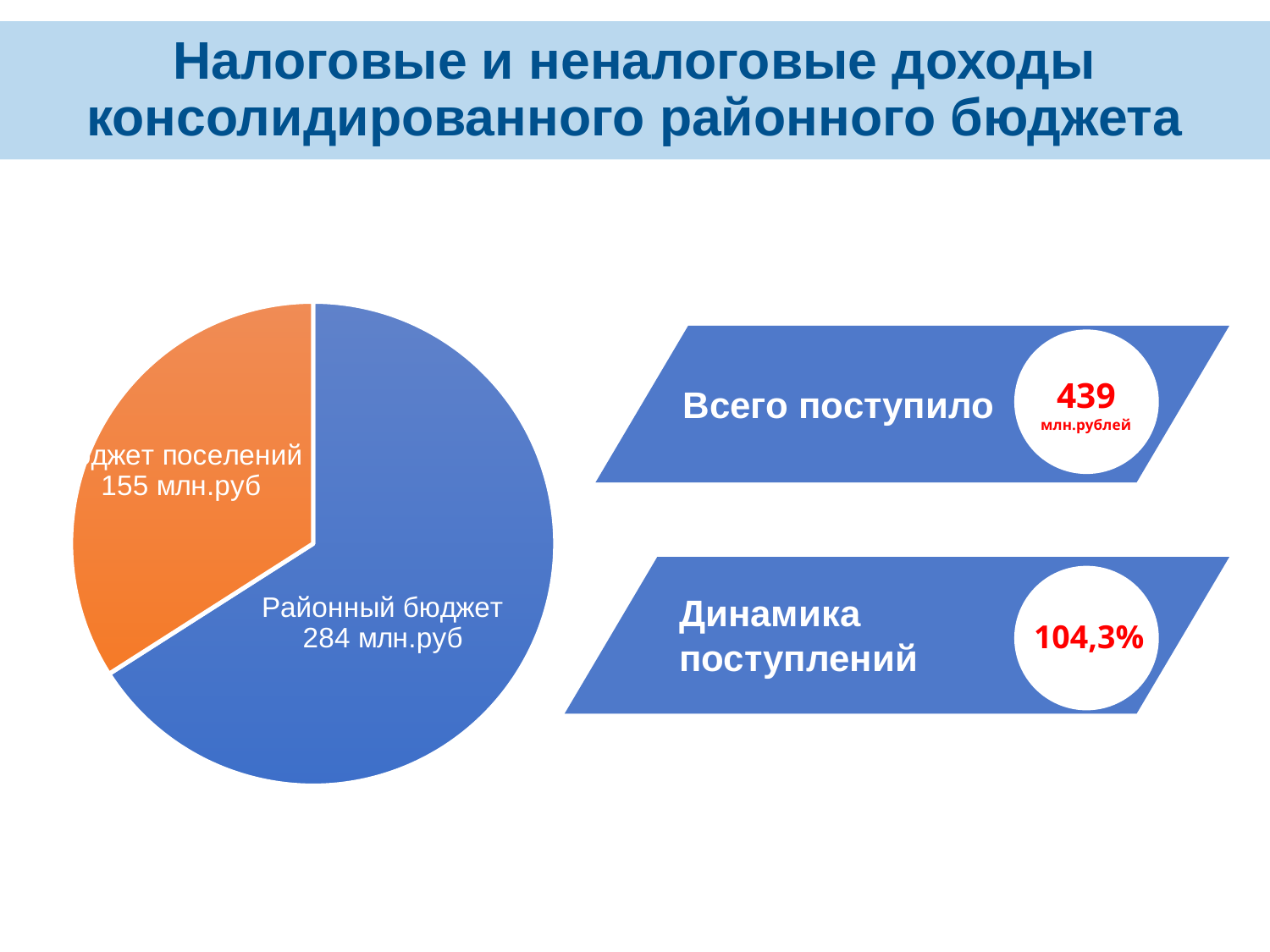
Which slice of the pie chart is the largest? Районный бюджет What value is shown next to 'Динамика поступлений' on the slide? 104,3% Which slice of the pie chart is the smallest? Бюджет поселений What is the total of the two slices in the pie chart? 439 млн.руб How many slices does the pie chart have? 2 What is the value of the Районный бюджет slice in the pie chart? 284 млн.руб What is the value of the orange slice (Бюджет поселений) in the pie chart? 155 млн.руб What colour is the Районный бюджет slice in the pie chart? Blue Which is larger in the pie chart: Районный бюджет or Бюджет поселений? Районный бюджет What kind of chart is shown on the slide? Pie chart What is the difference between the Районный бюджет and Бюджет поселений values in the pie chart? 129 млн.руб